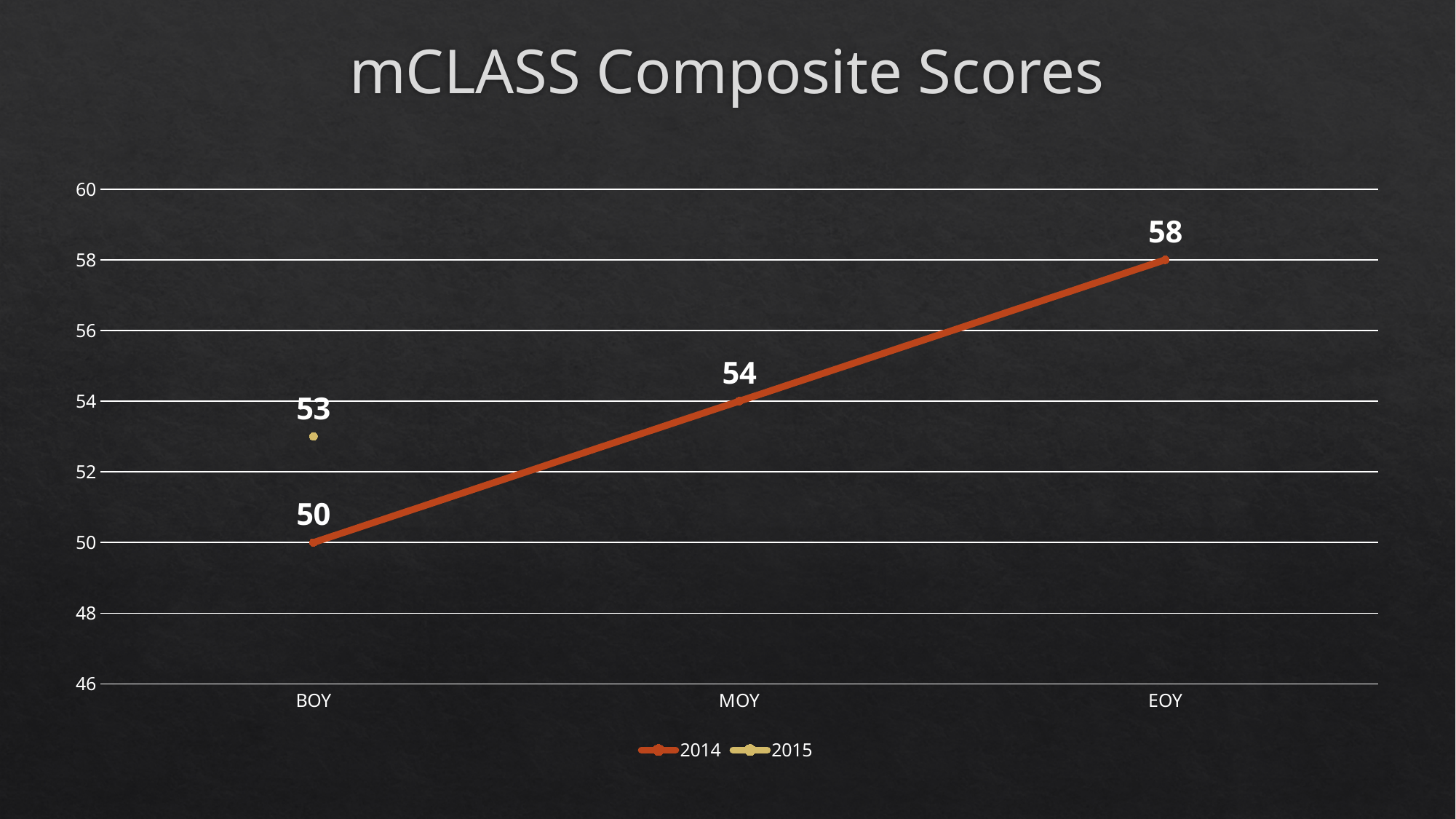
What kind of chart is this? line chart Does the 2014 series rise or fall from BOY to EOY? rise At BOY, which series has the larger value, 2014 or 2015? 2015 How many series does the legend list? 2 At which point is the 2014 series lowest? BOY What is the 2015 value at BOY? 53 What is the difference between the 2014 EOY value and the 2014 BOY value? 8 At which point is the 2014 series highest? EOY What is the 2014 value at MOY? 54 What is the 2014 value at BOY? 50 What is the 2014 value at EOY? 58 How many categories are on the x axis? 3